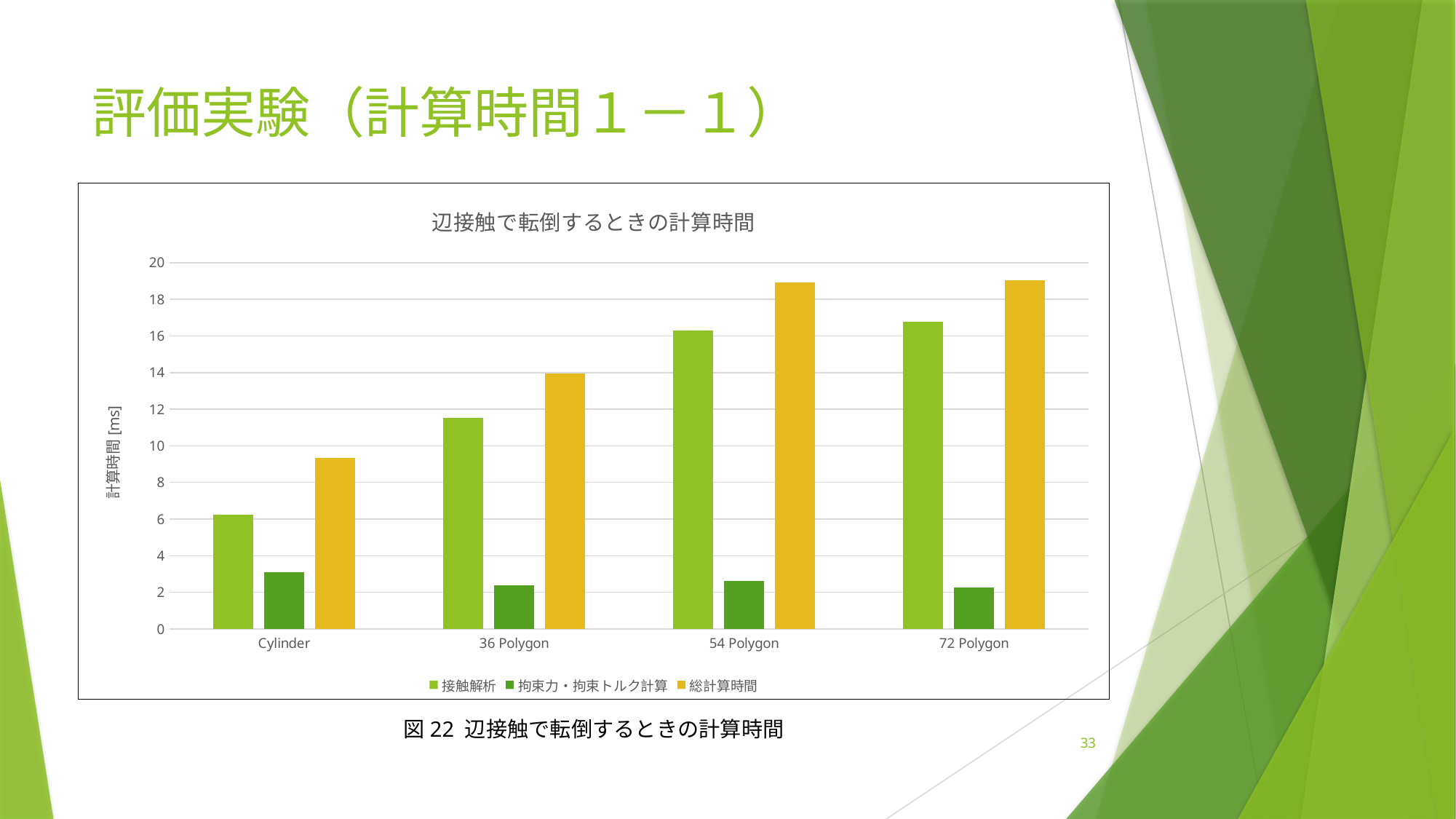
Which category has the highest value for 拘束力・拘束トルク計算? Cylinder How many series does the chart's legend list? 3 Is the value of 接触解析 for 36 Polygon greater or less than 10? greater What kind of chart is shown on the slide? Bar chart What is the label of the vertical axis of the chart? 計算時間 [ms] Does the value of 総計算時間 rise or fall from Cylinder to 72 Polygon along the x axis? rise Is the value of 総計算時間 for Cylinder greater or less than 10? less How many categories are shown on the x axis of the chart? 4 Which category has the lowest value for 接触解析? Cylinder Is the value of 総計算時間 for 54 Polygon greater or less than 18? greater Which category has the lowest value for 総計算時間? Cylinder What is the title of the chart? 辺接触で転倒するときの計算時間